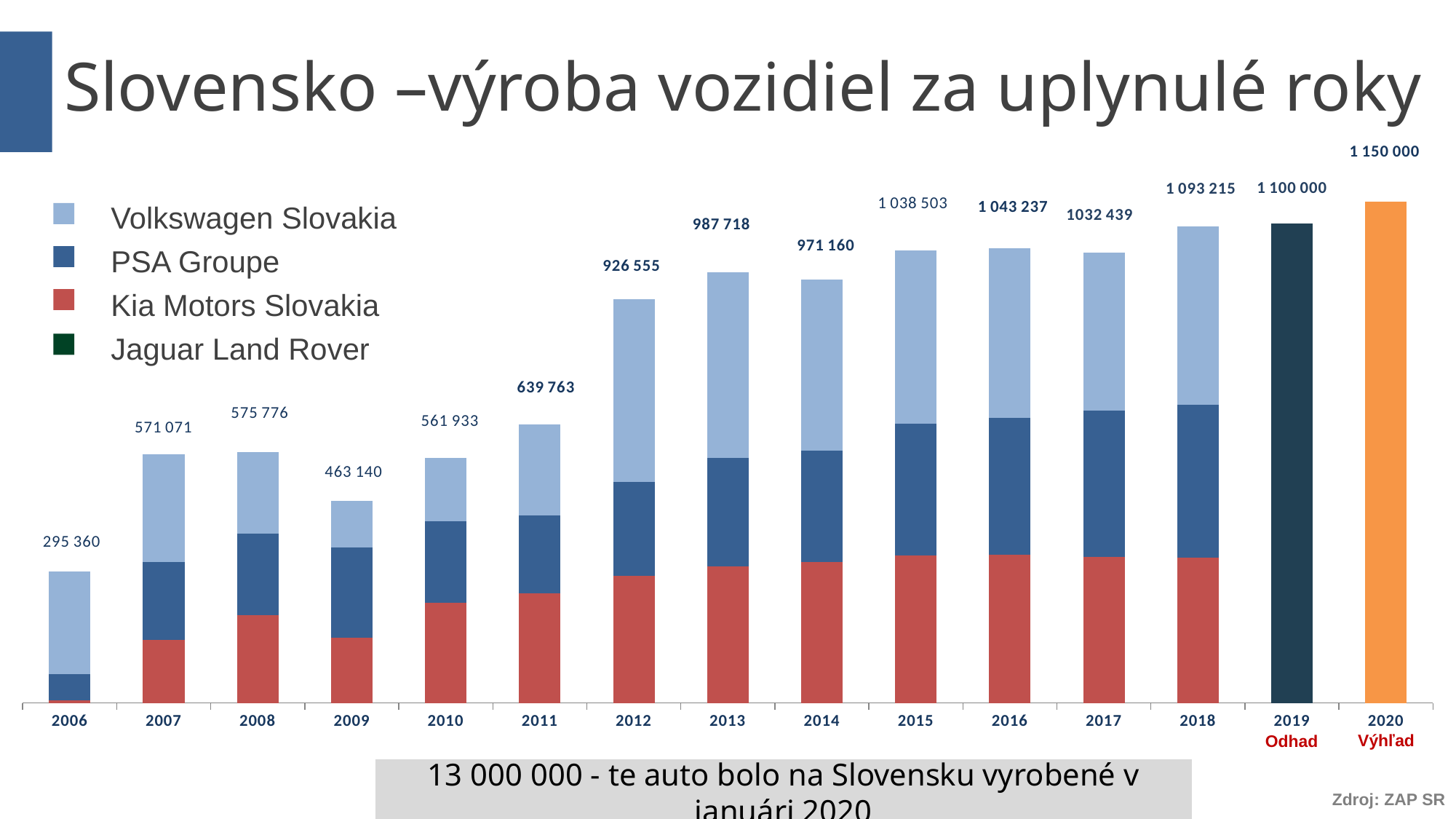
How many series does the legend list? 4 What is the total value labelled for 2018? 1 093 215 Which year has the lowest total value on the chart? 2006 What is the difference between the total for 2018 and the total for 2017? 60 776 Which year has the larger total, 2013 or 2014? 2013 Which year has the highest total value on the chart? 2020 What is the total value labelled for 2006? 295 360 How many years are shown on the x axis? 15 What value is shown for the 2020 outlook (Výhľad) bar? 1 150 000 What kind of chart is shown on the slide? Stacked bar chart What is the difference between the 2020 outlook value and the 2019 estimate? 50 000 What is the total vehicle production shown for 2012? 926 555